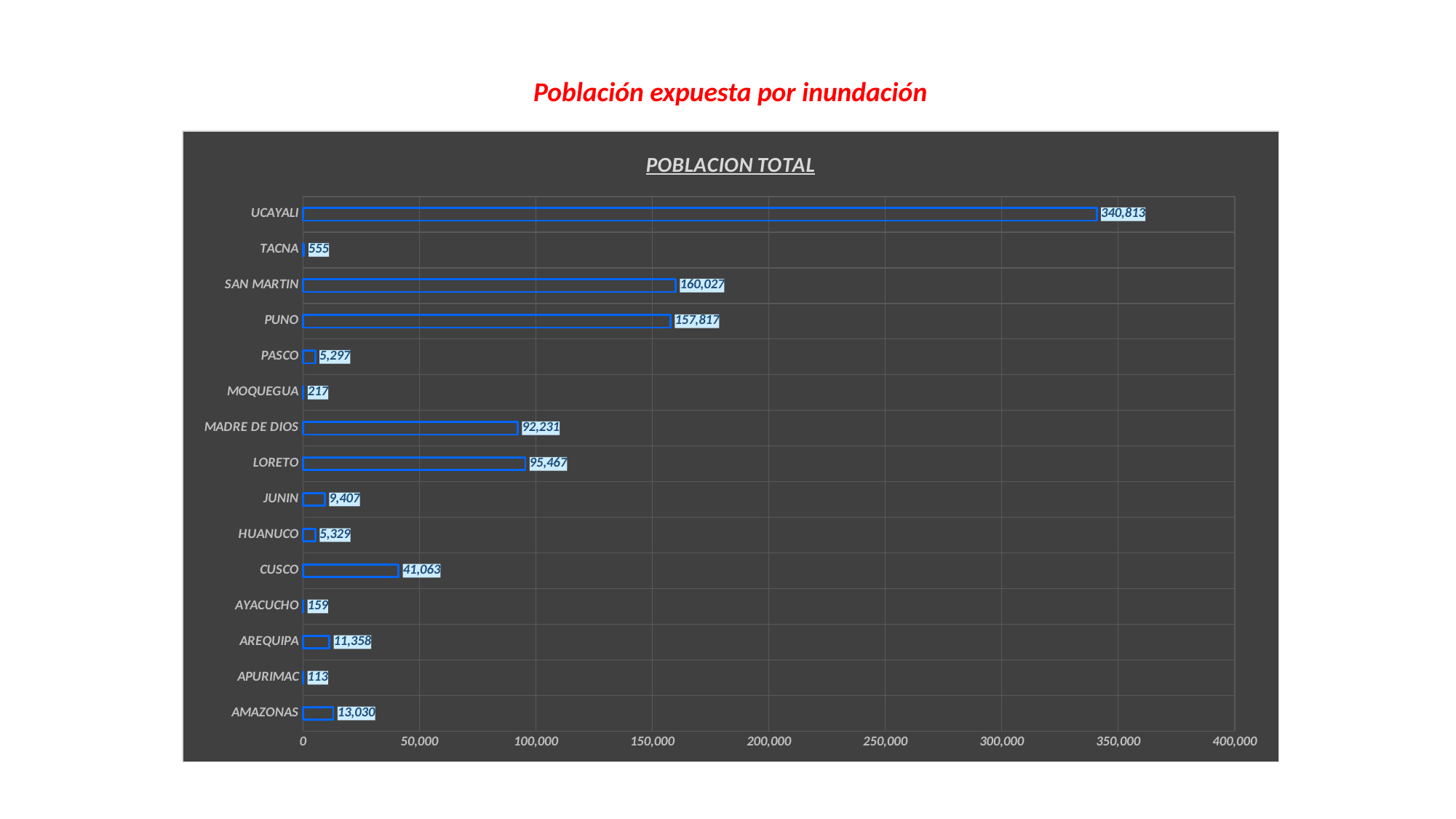
Which category has the highest value? UCAYALI How many categories are shown in the chart? 15 What is the difference between the values for SAN MARTIN and PUNO? 2,210 Which category has the lowest value? APURIMAC What is the difference between the values for AMAZONAS and JUNIN? 3,623 What is the value for AREQUIPA? 11,358 What is the title of the chart? POBLACION TOTAL Is the value for CUSCO greater or less than 50,000? less What is the value for UCAYALI? 340,813 Which has a larger value, LORETO or MADRE DE DIOS? LORETO What is the value for MADRE DE DIOS? 92,231 What kind of chart is shown? bar chart